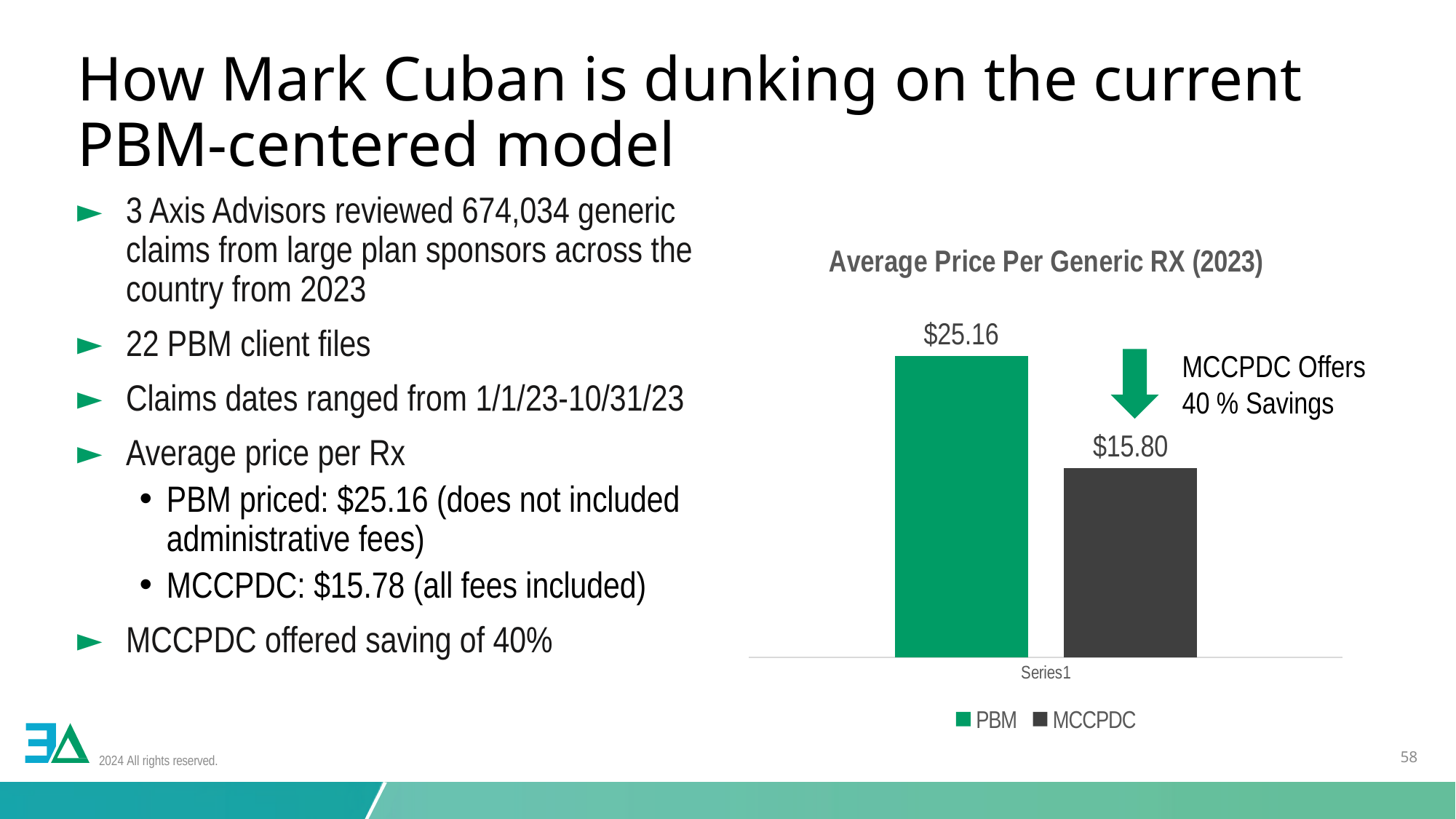
What savings percentage does the annotation next to the chart say MCCPDC offers? 40 % What is the title of the chart? Average Price Per Generic RX (2023) Which series has the lower average price per generic Rx? MCCPDC What is the category label shown on the x axis? Series1 What kind of chart is shown on the slide? bar chart What is the value for MCCPDC in the chart? $15.80 Which series has the higher average price per generic Rx? PBM Is the value for PBM larger or smaller than the value for MCCPDC? larger What is the value for PBM in the chart? $25.16 What is the difference between the PBM and MCCPDC values? $9.36 What colour is the PBM bar? green How many series does the legend list? 2